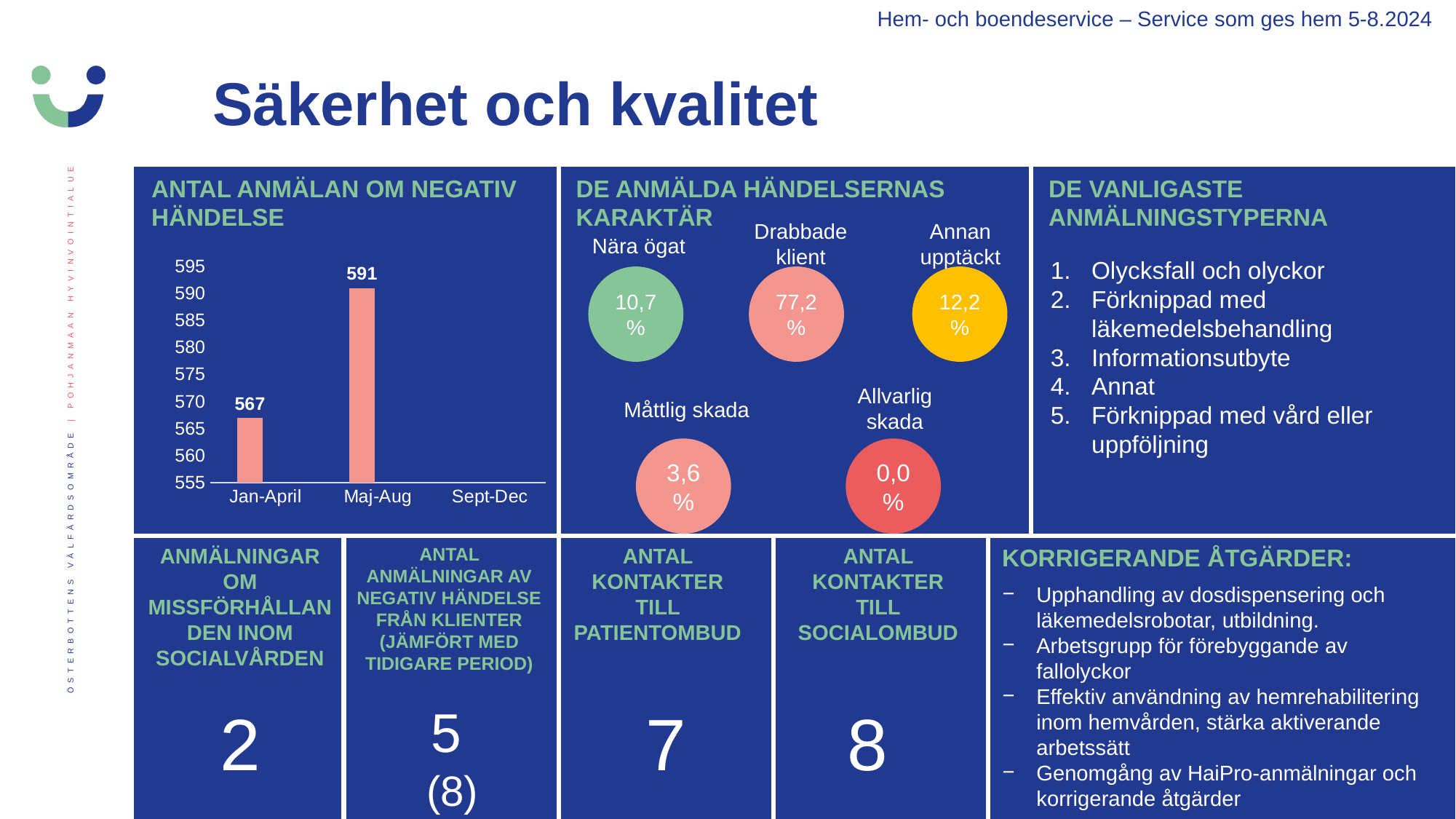
In the chart 'ANTAL ANMÄLAN OM NEGATIV HÄNDELSE', what is the difference between the Maj-Aug and Jan-April values? 24 In the chart 'ANTAL ANMÄLAN OM NEGATIV HÄNDELSE', how many categories are shown on the x axis? 3 In the chart 'ANTAL ANMÄLAN OM NEGATIV HÄNDELSE', do the values rise or fall from Jan-April to Maj-Aug? rise In the chart 'ANTAL ANMÄLAN OM NEGATIV HÄNDELSE', is the value for Jan-April greater or less than 570? less In the chart 'ANTAL ANMÄLAN OM NEGATIV HÄNDELSE', what is the value for Maj-Aug? 591 What kind of chart is 'ANTAL ANMÄLAN OM NEGATIV HÄNDELSE'? bar chart In the chart 'ANTAL ANMÄLAN OM NEGATIV HÄNDELSE', how many bars are plotted? 2 In the chart 'ANTAL ANMÄLAN OM NEGATIV HÄNDELSE', which of the plotted periods has the lowest value? Jan-April In the chart 'ANTAL ANMÄLAN OM NEGATIV HÄNDELSE', what is the value for Jan-April? 567 In the chart 'ANTAL ANMÄLAN OM NEGATIV HÄNDELSE', is the value for Maj-Aug greater or less than 590? greater In the chart 'ANTAL ANMÄLAN OM NEGATIV HÄNDELSE', which is larger, Jan-April or Maj-Aug? Maj-Aug In the chart 'ANTAL ANMÄLAN OM NEGATIV HÄNDELSE', which period has the highest value? Maj-Aug